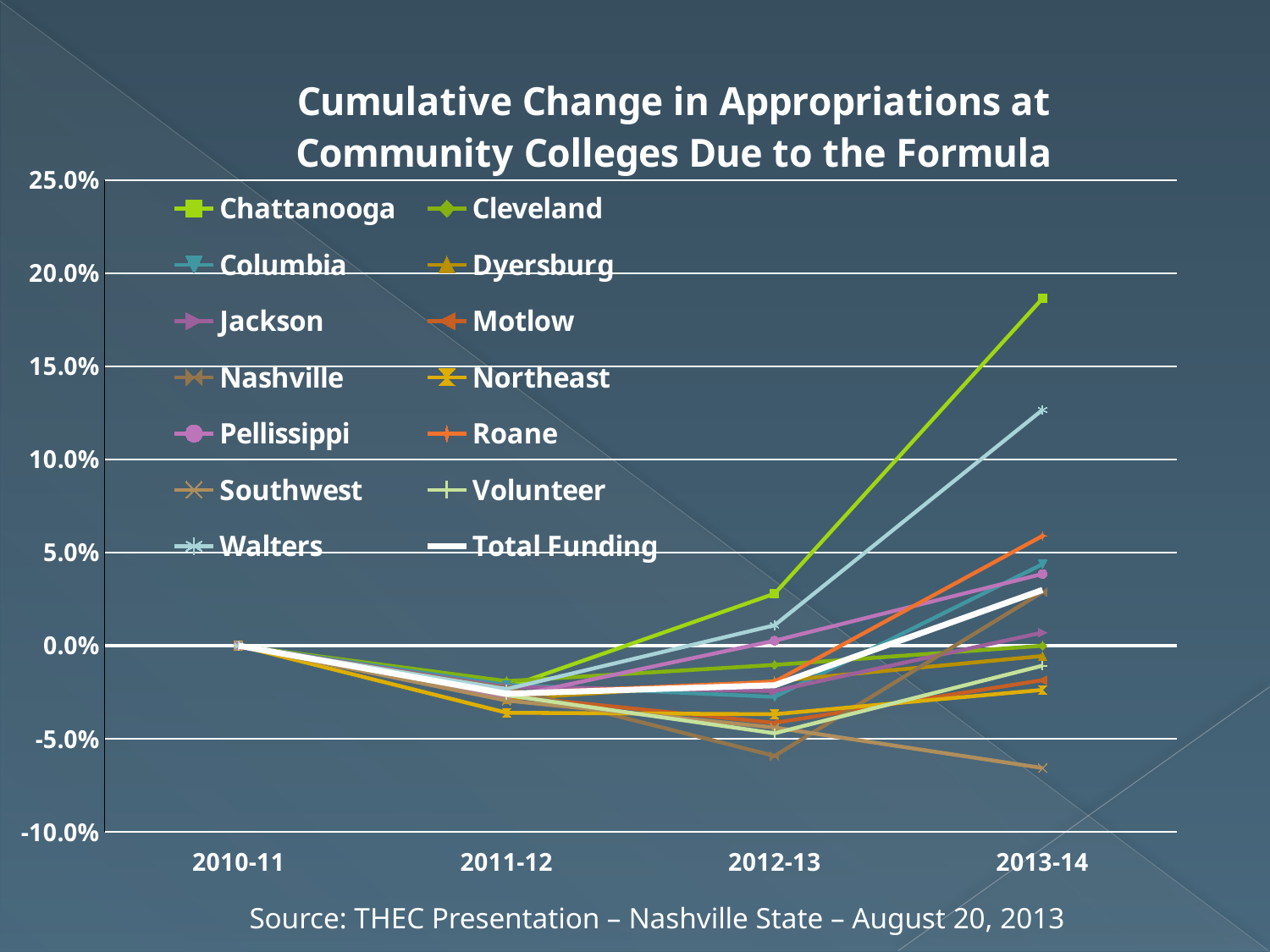
What is the value for Chattanooga in 2010-11? 0.0% Which is larger in 2013-14, Chattanooga or Walters? Chattanooga How many academic years are shown on the x axis? 4 What kind of chart is shown on the slide? line chart Is the value for Chattanooga in 2013-14 greater or less than 15.0%? greater What is the title of the chart? Cumulative Change in Appropriations at Community Colleges Due to the Formula How many series does the legend list? 14 What is the value for Total Funding in 2010-11? 0.0% Is the value for Total Funding in 2013-14 greater or less than 0.0%? greater Which series has the highest value in 2013-14? Chattanooga Is the value for Walters in 2013-14 greater or less than 10.0%? greater Does the Chattanooga line rise or fall from 2011-12 to 2013-14? rise